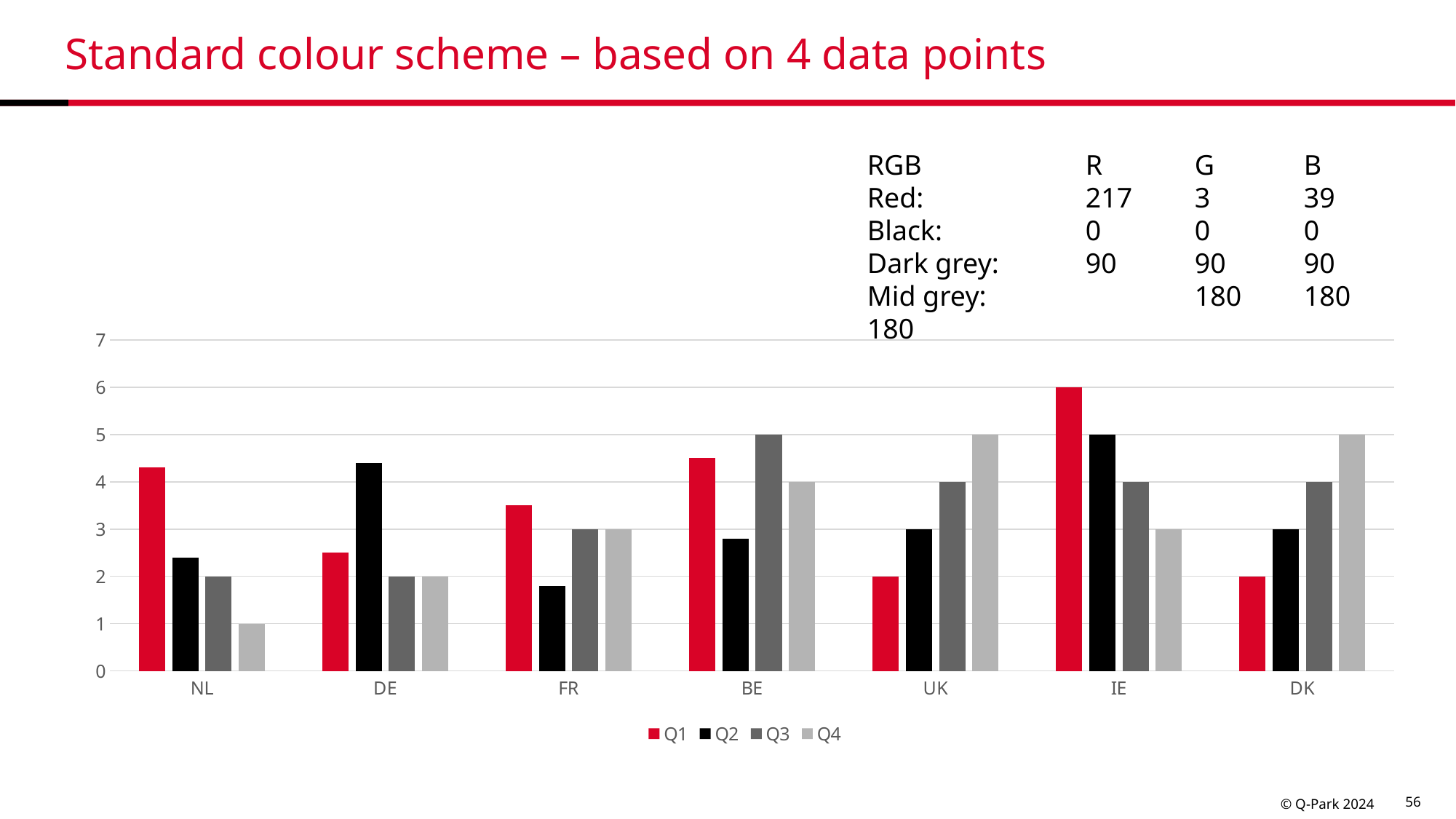
What is the Q4 value for UK? 5 What type of chart is shown on the slide? bar chart Is the Q2 value for FR greater or less than 2? less What is the Q4 value for NL? 1 Is the Q1 value for NL greater or less than 4? greater What is the Q3 value for BE? 5 What is the Q1 value for IE? 6 What is the difference between the Q1 value for IE and the Q1 value for DK? 4 How many series does the legend list? 4 Which category has the highest Q1 value? IE Which category has the lowest Q4 value? NL How many categories are shown on the x axis? 7